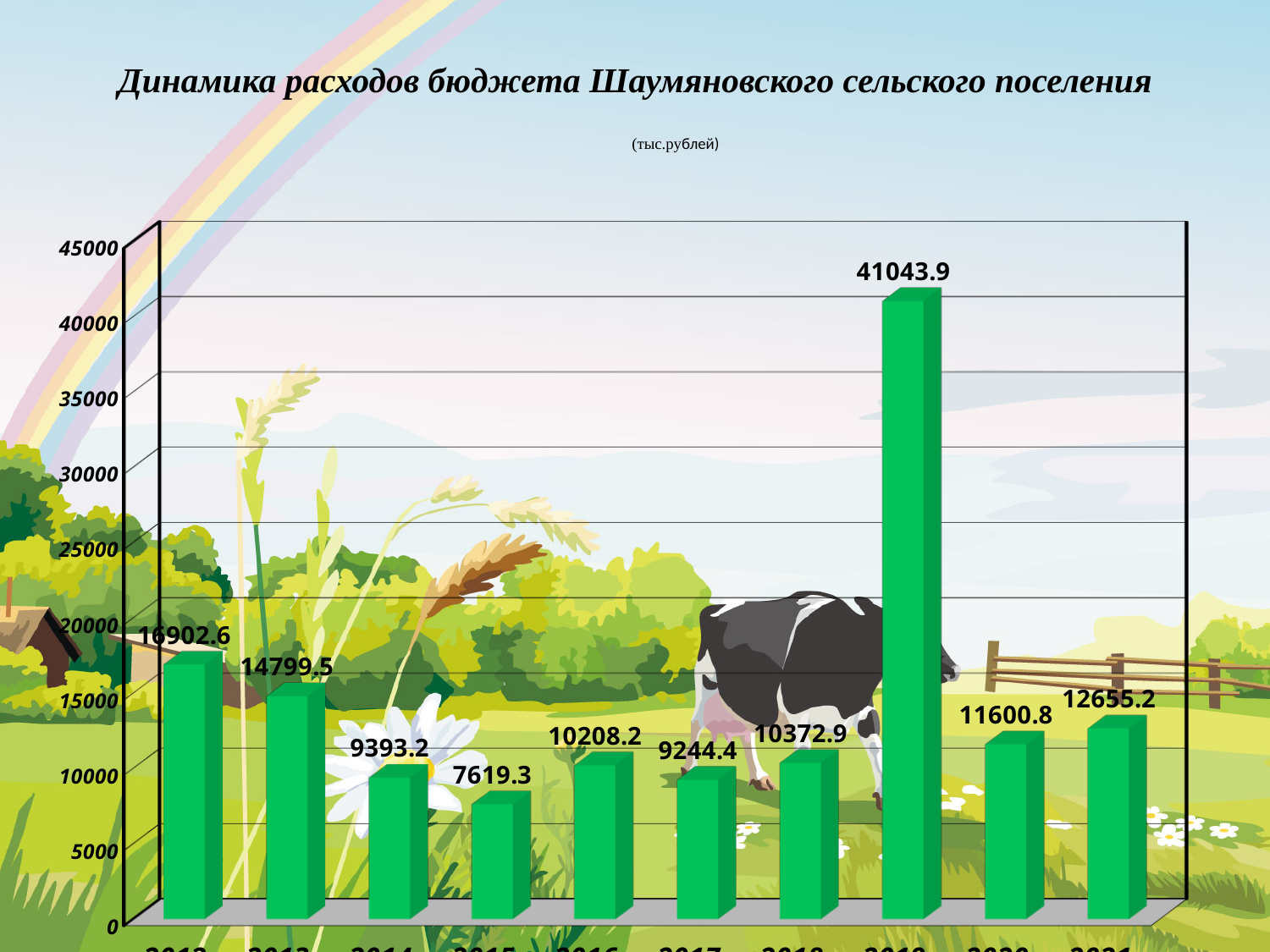
What kind of chart is shown on the slide? bar chart Which is larger: the fifth bar from the left (10208.2) or the sixth bar (9244.4)? the fifth bar (10208.2) What is the value of the first bar from the left? 16902.6 How many bars are plotted in the chart? 10 What unit is given under the chart title? тыс.рублей What is the difference between the first bar (16902.6) and the second bar (14799.5)? 2103.1 What is the lowest value shown in the chart? 7619.3 Do the values rise or fall from the first bar to the fourth bar? fall What is the value of the last bar on the right? 12655.2 Is the value of the tallest bar greater or less than 40000? greater What is the highest value shown in the chart? 41043.9 What is the difference between the tallest bar (41043.9) and the bar immediately to its right (11600.8)? 29443.1